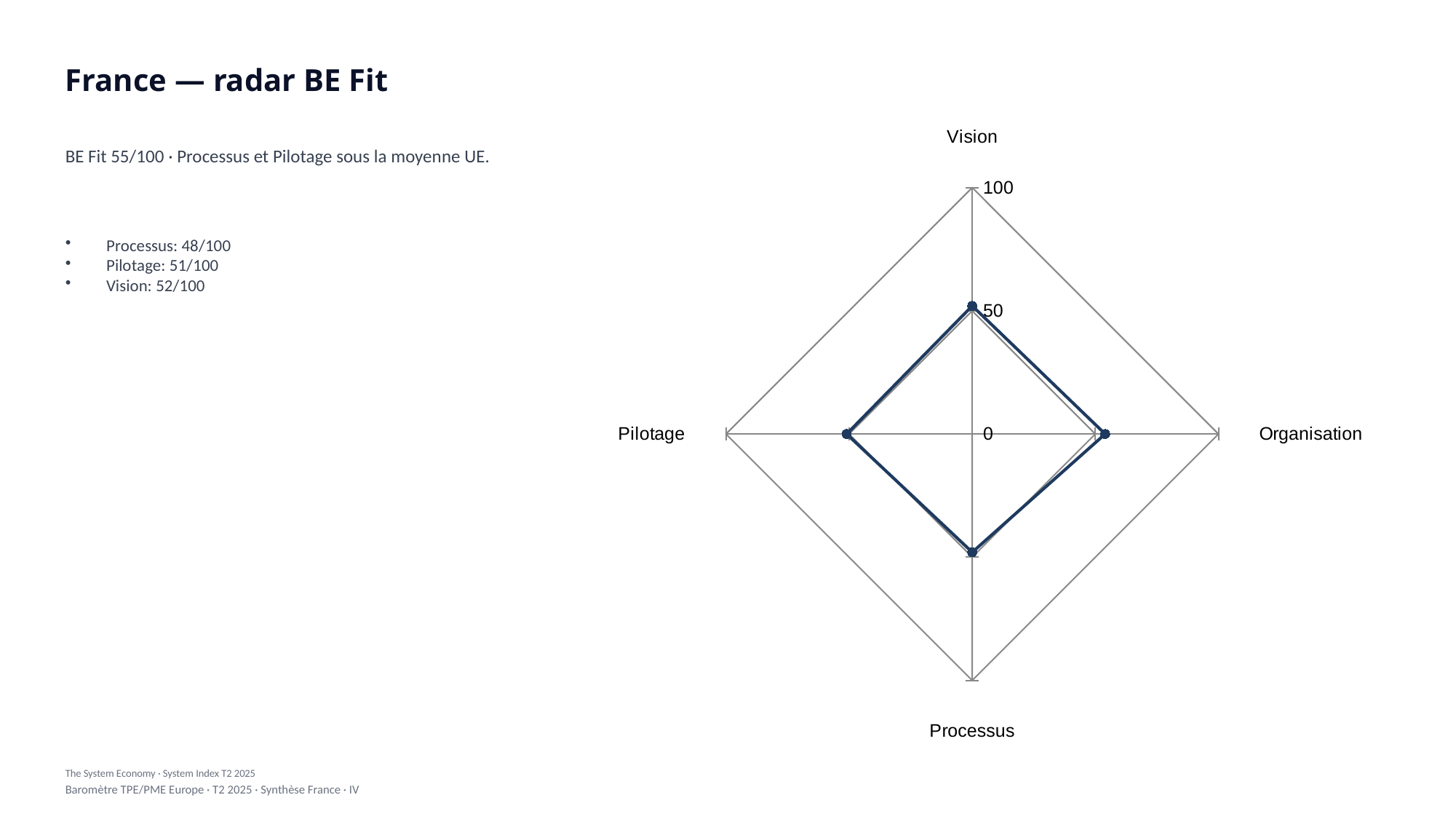
What is the value for Vision? 52/100 Is the value for Vision greater or less than 100? less What is the difference between the Vision and Processus values? 4 Which is larger, the value for Vision or the value for Processus? Vision What is the value for Processus? 48/100 What is the maximum value shown on the radar chart's axis scale? 100 What is the title of the slide containing the radar chart? France — radar BE Fit Which is larger, the value for Pilotage or the value for Processus? Pilotage What is the value for Pilotage? 51/100 How many axes (categories) does the radar chart have? 4 What kind of chart is shown on the slide? radar chart